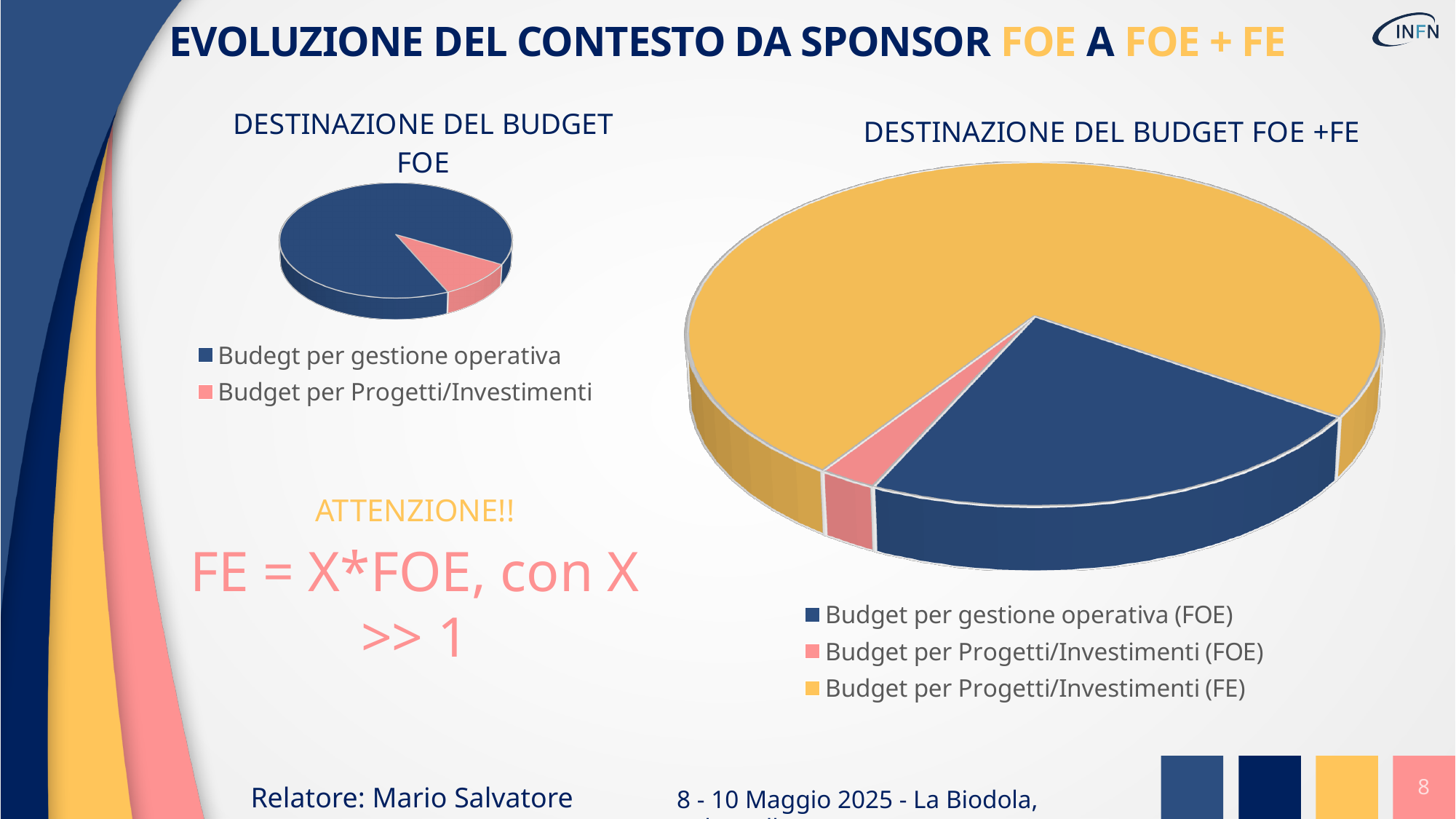
In the 'DESTINAZIONE DEL BUDGET FOE' chart, which category has the largest slice? Budegt per gestione operativa What kind of chart is the 'DESTINAZIONE DEL BUDGET FOE' chart on the left? Pie chart What kind of chart is the 'DESTINAZIONE DEL BUDGET FOE +FE' chart on the right? Pie chart In the 'DESTINAZIONE DEL BUDGET FOE +FE' chart, which slice is larger: 'Budget per gestione operativa (FOE)' or 'Budget per Progetti/Investimenti (FOE)'? Budget per gestione operativa (FOE) In the 'DESTINAZIONE DEL BUDGET FOE +FE' chart, which category has the smallest slice? Budget per Progetti/Investimenti (FOE) In the 'DESTINAZIONE DEL BUDGET FOE +FE' chart, which category has the largest slice? Budget per Progetti/Investimenti (FE) In the 'DESTINAZIONE DEL BUDGET FOE' chart, which category has the smallest slice? Budget per Progetti/Investimenti In the 'DESTINAZIONE DEL BUDGET FOE' chart, how many slices does the pie have? 2 In the 'DESTINAZIONE DEL BUDGET FOE +FE' chart, what colour is the 'Budget per Progetti/Investimenti (FE)' slice? Yellow How many entries does the legend of the 'DESTINAZIONE DEL BUDGET FOE +FE' chart list? 3 How many entries does the legend of the 'DESTINAZIONE DEL BUDGET FOE' chart list? 2 In the 'DESTINAZIONE DEL BUDGET FOE +FE' chart, how many slices does the pie have? 3